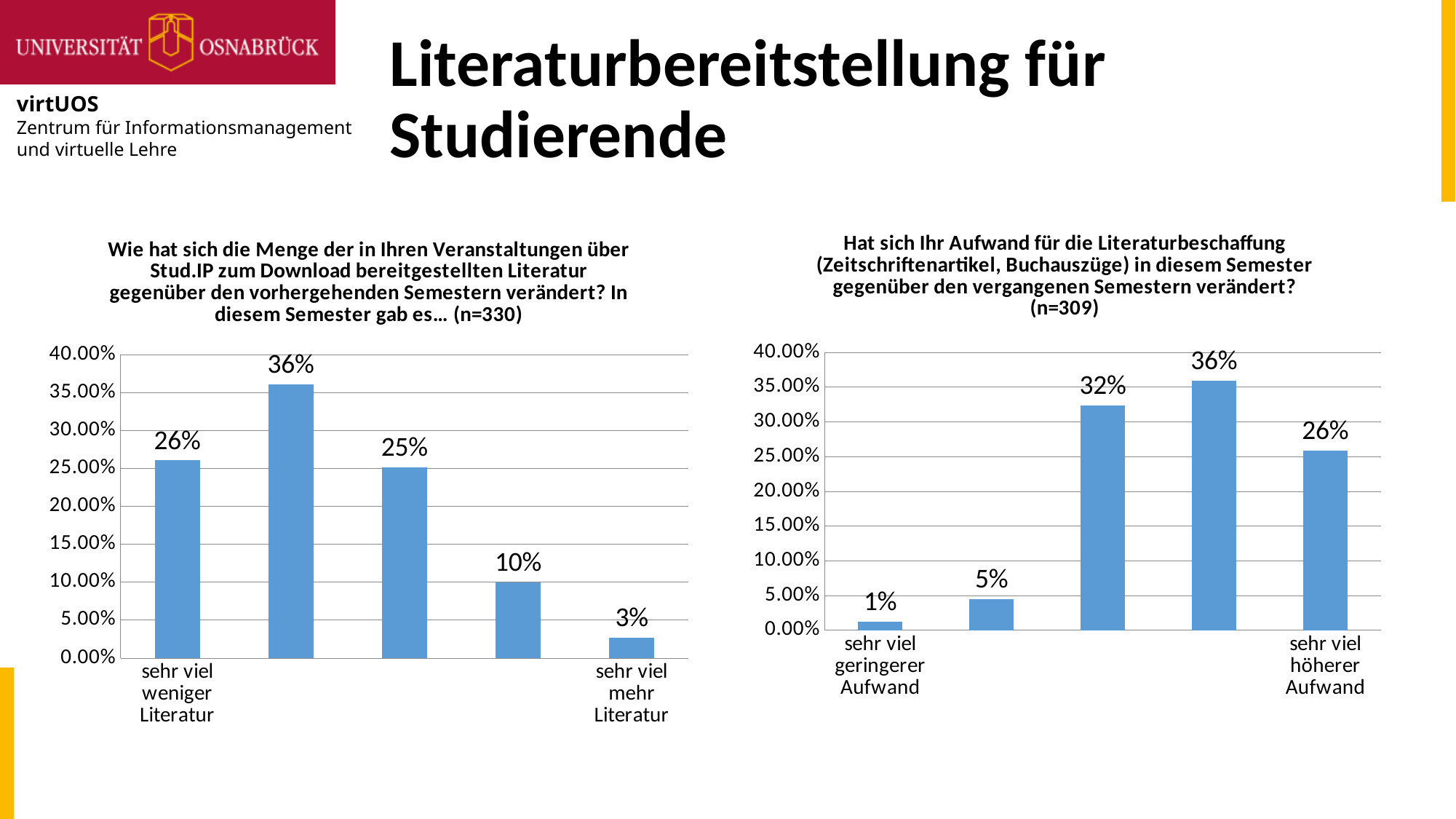
What is the sample size (n) stated in the title of the right chart? 309 In the right chart, which is larger: the value for "sehr viel geringerer Aufwand" or "sehr viel höherer Aufwand"? sehr viel höherer Aufwand In the left chart, what is the difference between the values for "sehr viel weniger Literatur" and "sehr viel mehr Literatur"? 23% In the right chart, what is the value for "sehr viel geringerer Aufwand"? 1% What type of chart is the right chart? bar chart In the right chart, which category has the lowest value? sehr viel geringerer Aufwand In the left chart, what is the value for "sehr viel mehr Literatur"? 3% In the left chart, what is the value for "sehr viel weniger Literatur"? 26% How many bars does the left chart have? 5 How many bars does the right chart have? 5 In the left chart, what is the highest value shown on any bar? 36% In the right chart, what is the value for "sehr viel höherer Aufwand"? 26%